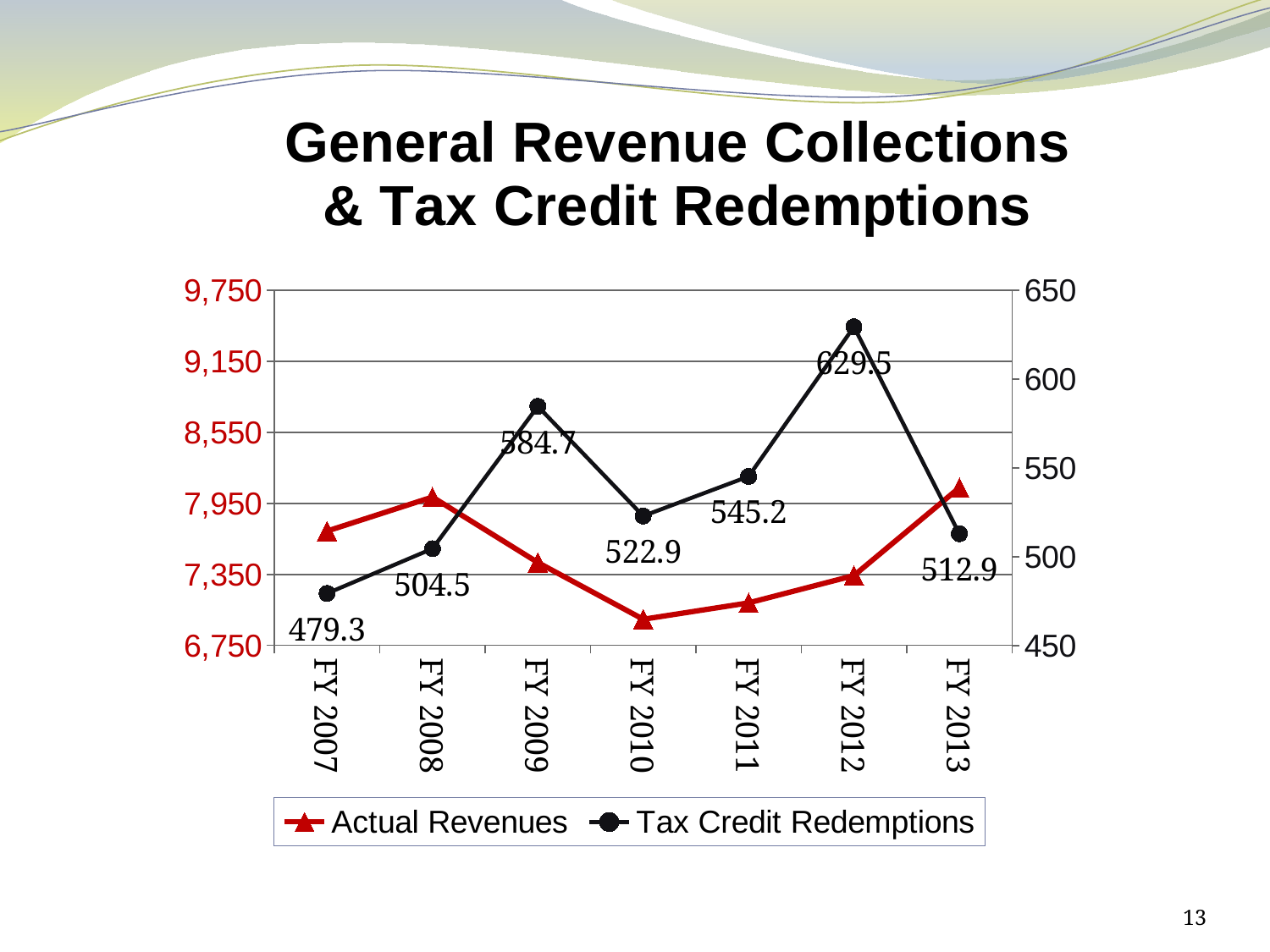
How many series does the legend list? 2 Is the value of Actual Revenues for FY 2007 greater or less than 7,950? less Which year has higher Tax Credit Redemptions, FY 2009 or FY 2011? FY 2009 Is the value of Actual Revenues for FY 2010 greater or less than 7,350? less What is the difference between Tax Credit Redemptions in FY 2012 and FY 2007? 150.2 In which fiscal year are Tax Credit Redemptions lowest? FY 2007 How many fiscal years are shown on the x axis? 7 What is the value of Tax Credit Redemptions for FY 2007? 479.3 What is the value of Tax Credit Redemptions for FY 2012? 629.5 What kind of chart is shown on the slide? line chart In which fiscal year are Tax Credit Redemptions highest? FY 2012 What is the value of Tax Credit Redemptions for FY 2010? 522.9